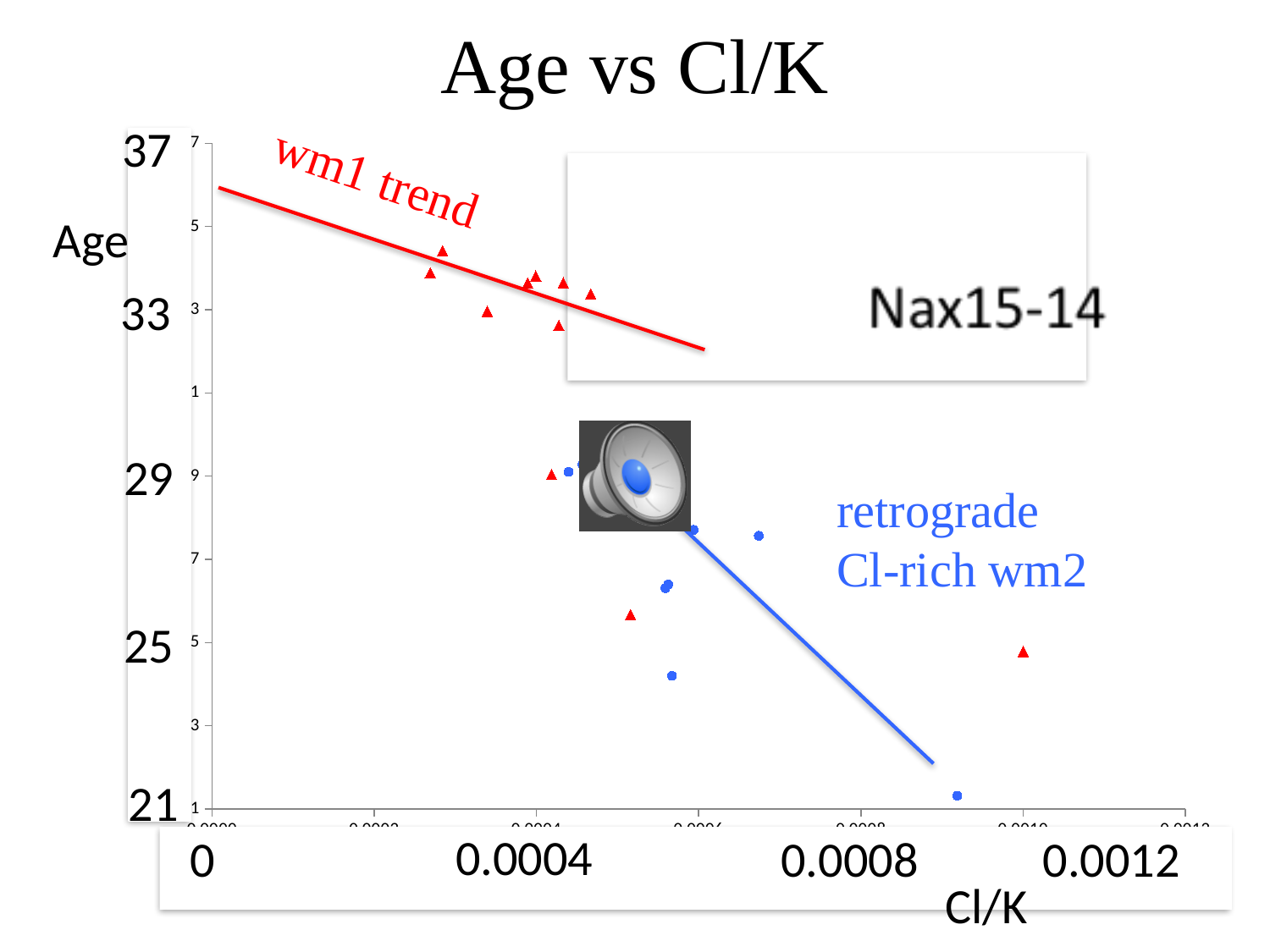
What is the title of the chart? Age vs Cl/K Does the blue wm2 trend line rise or fall as Cl/K increases? fall Are the ages of the blue circles greater or less than 33? less Does the red wm1 trend line rise or fall as Cl/K increases? fall Which has the higher age: the rightmost blue circle or the rightmost red triangle? the rightmost red triangle Is the age of the lowest blue circle greater or less than 25? less What kind of chart is shown on the slide? scatter chart Is the age of the highest red triangle greater or less than 33? greater What label is written next to the blue trend line? retrograde Cl-rich wm2